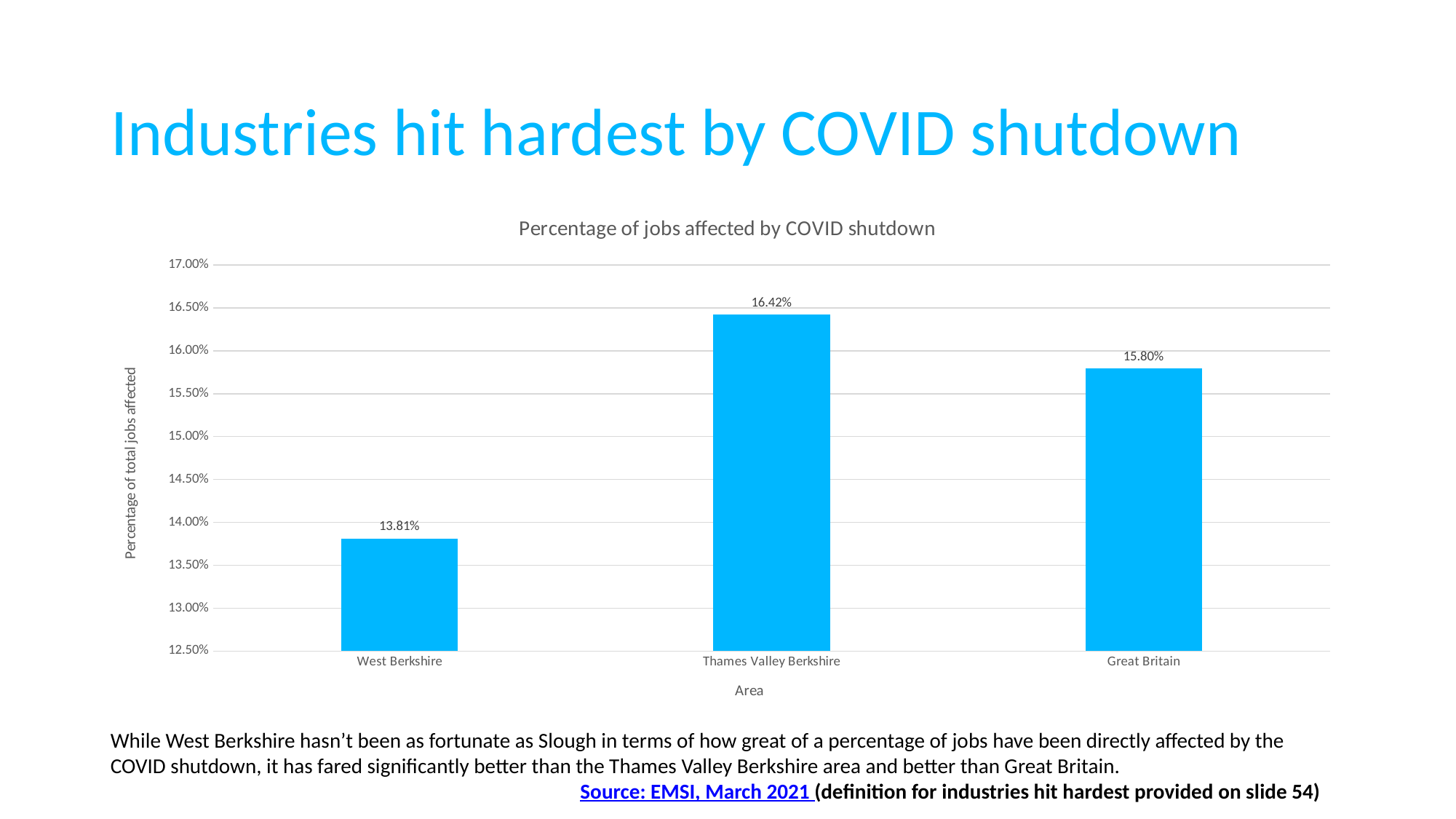
Which has a higher percentage of jobs affected, Great Britain or Thames Valley Berkshire? Thames Valley Berkshire What is the percentage of jobs affected by COVID shutdown for West Berkshire? 13.81% What is the difference in percentage points between Great Britain and West Berkshire? 1.99% What is the title of the chart? Percentage of jobs affected by COVID shutdown What is the percentage of jobs affected by COVID shutdown for Thames Valley Berkshire? 16.42% What kind of chart is shown on the slide? Bar chart What is the percentage of jobs affected by COVID shutdown for Great Britain? 15.80% Which area has the lowest percentage of jobs affected by COVID shutdown? West Berkshire What is the difference in percentage points between Thames Valley Berkshire and West Berkshire? 2.61% Is the value for West Berkshire greater or less than 14.00%? less Which area has the highest percentage of jobs affected by COVID shutdown? Thames Valley Berkshire How many areas are shown in the chart? 3